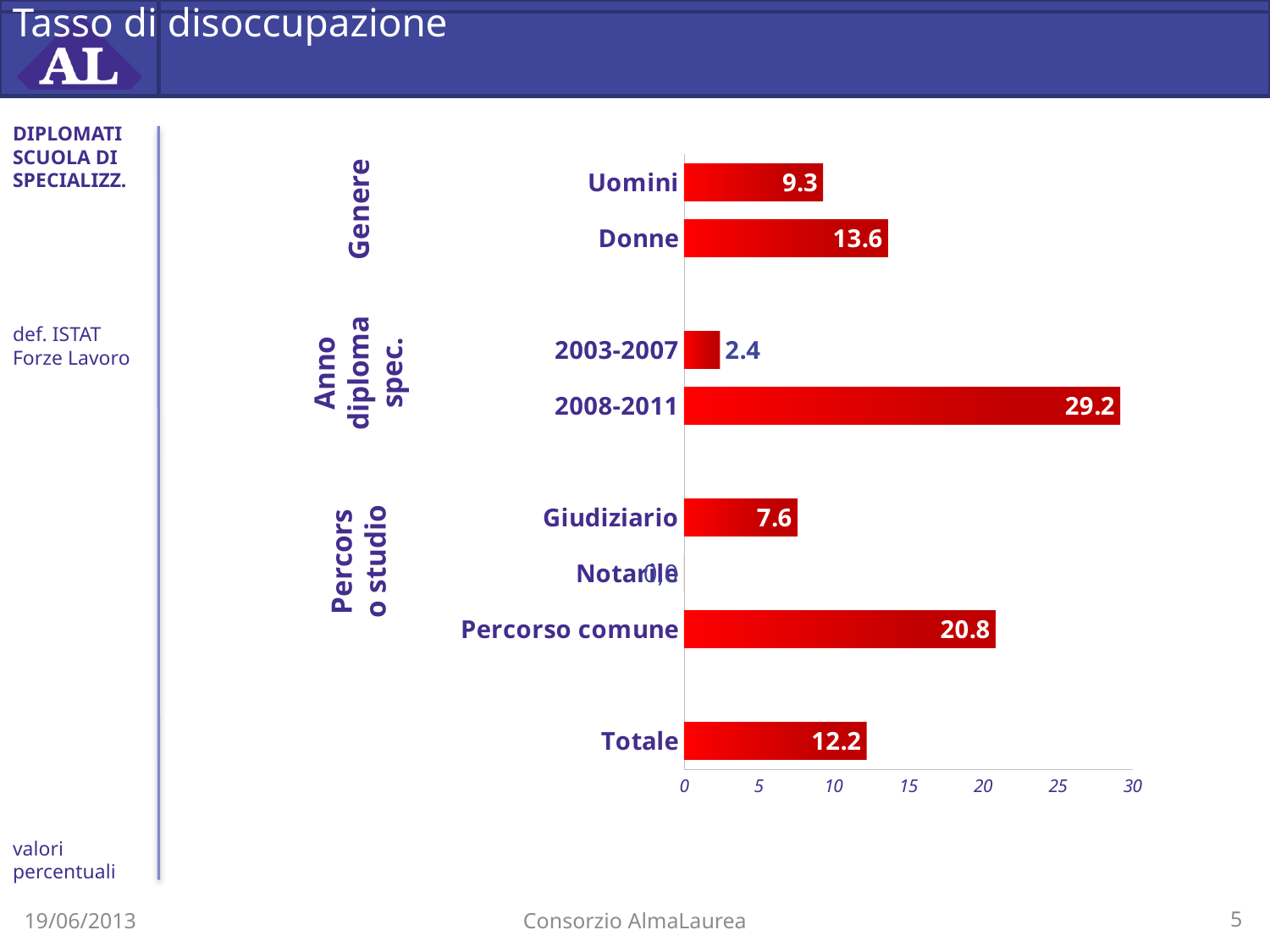
Which has a larger value, Giudiziario or Percorso comune? Percorso comune What is the difference between the values for 2008-2011 and 2003-2007? 26.8 Is the value for Totale greater or less than 10? greater What value is shown for the 2008-2011 diploma year group? 29.2 What is the difference between the values for Donne and Uomini? 4.3 What value is shown for Totale? 12.2 What value is shown for Percorso comune? 20.8 What is the title of the slide containing the chart? Tasso di disoccupazione What kind of chart is shown on the slide? Bar chart Which category has the highest value in the chart? 2008-2011 What is the unemployment rate value shown for Uomini? 9.3 What value is shown for Donne? 13.6